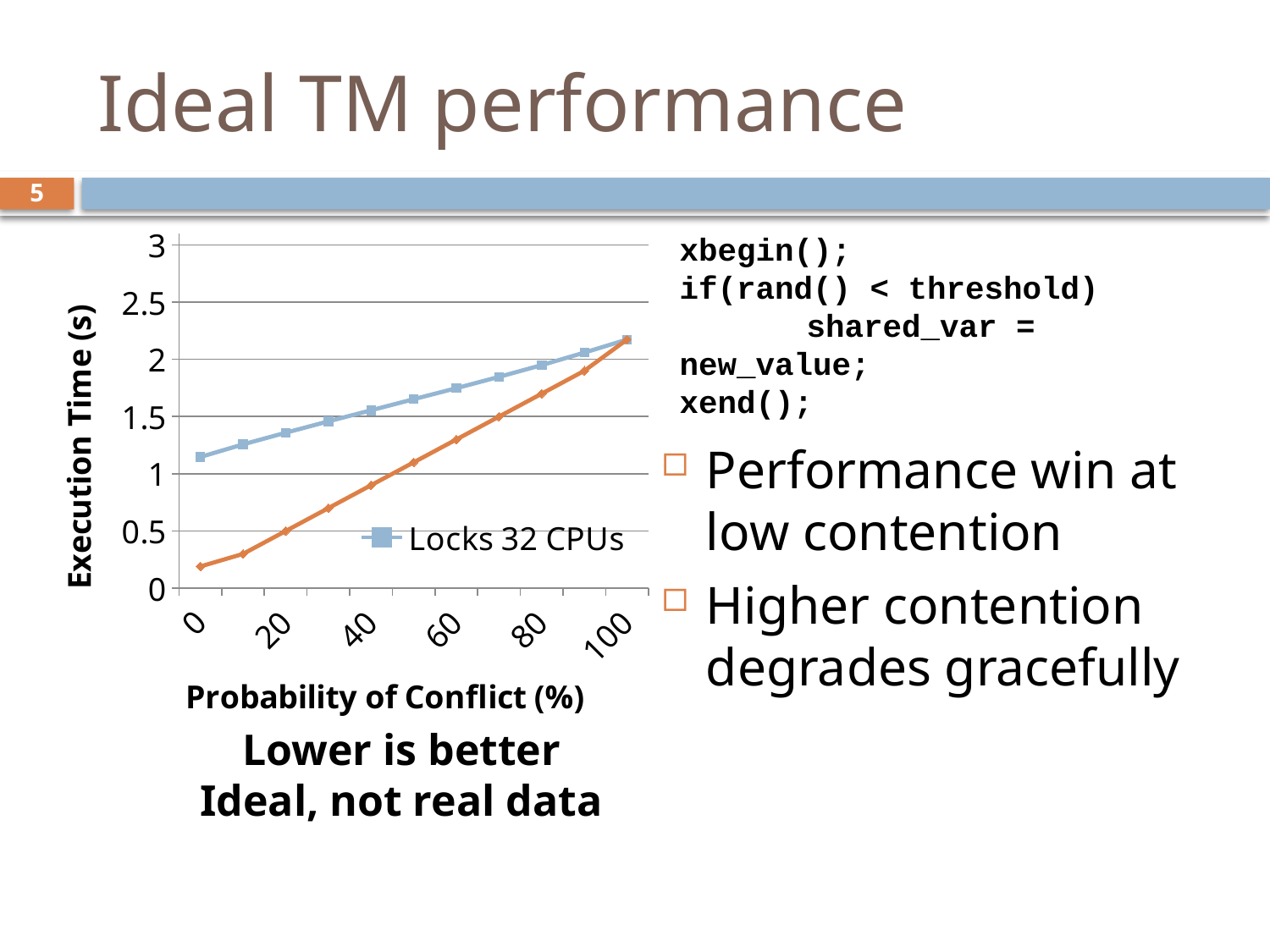
Is the value for the orange series at 40% Probability of Conflict greater or less than 1? less What is the series name shown in the chart's legend? Locks 32 CPUs Is the value for Locks 32 CPUs at 0% Probability of Conflict greater or less than 1? greater What is the label of the chart's y axis? Execution Time (s) Is the value for Locks 32 CPUs at 100% Probability of Conflict greater or less than 2? greater Does the orange series rise or fall as Probability of Conflict increases? rise How many series does the chart's legend list? 1 How many data points are plotted for the Locks 32 CPUs series? 11 What kind of chart is shown on the slide? line chart At 0% Probability of Conflict, which series has the higher execution time, Locks 32 CPUs or the orange series? Locks 32 CPUs Does the Locks 32 CPUs series rise or fall as Probability of Conflict increases? rise